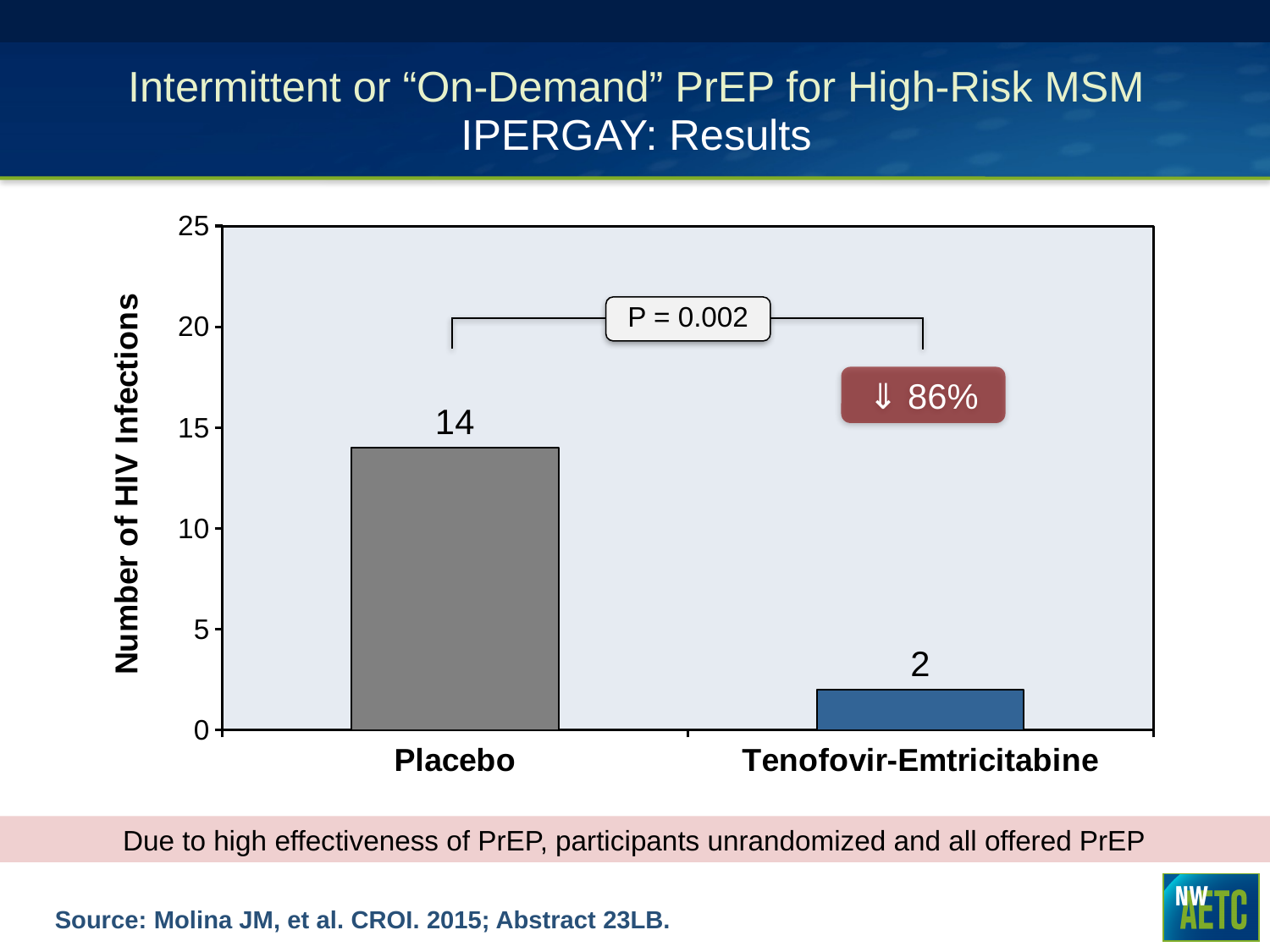
What is the number of HIV infections for Tenofovir-Emtricitabine? 2 Is the value for Placebo greater or less than 10? greater Which group has the higher number of HIV infections? Placebo How many groups are shown on the x axis of the chart? 2 What kind of chart is shown on the slide? Bar chart What is the label of the y axis of the chart? Number of HIV Infections What is the difference in the number of HIV infections between Placebo and Tenofovir-Emtricitabine? 12 Is the value for Tenofovir-Emtricitabine greater or less than 5? less What P value is shown on the chart comparing the two groups? P = 0.002 Is the number of HIV infections larger for Placebo or for Tenofovir-Emtricitabine? Placebo What is the number of HIV infections for Placebo? 14 Which group has the lower number of HIV infections? Tenofovir-Emtricitabine